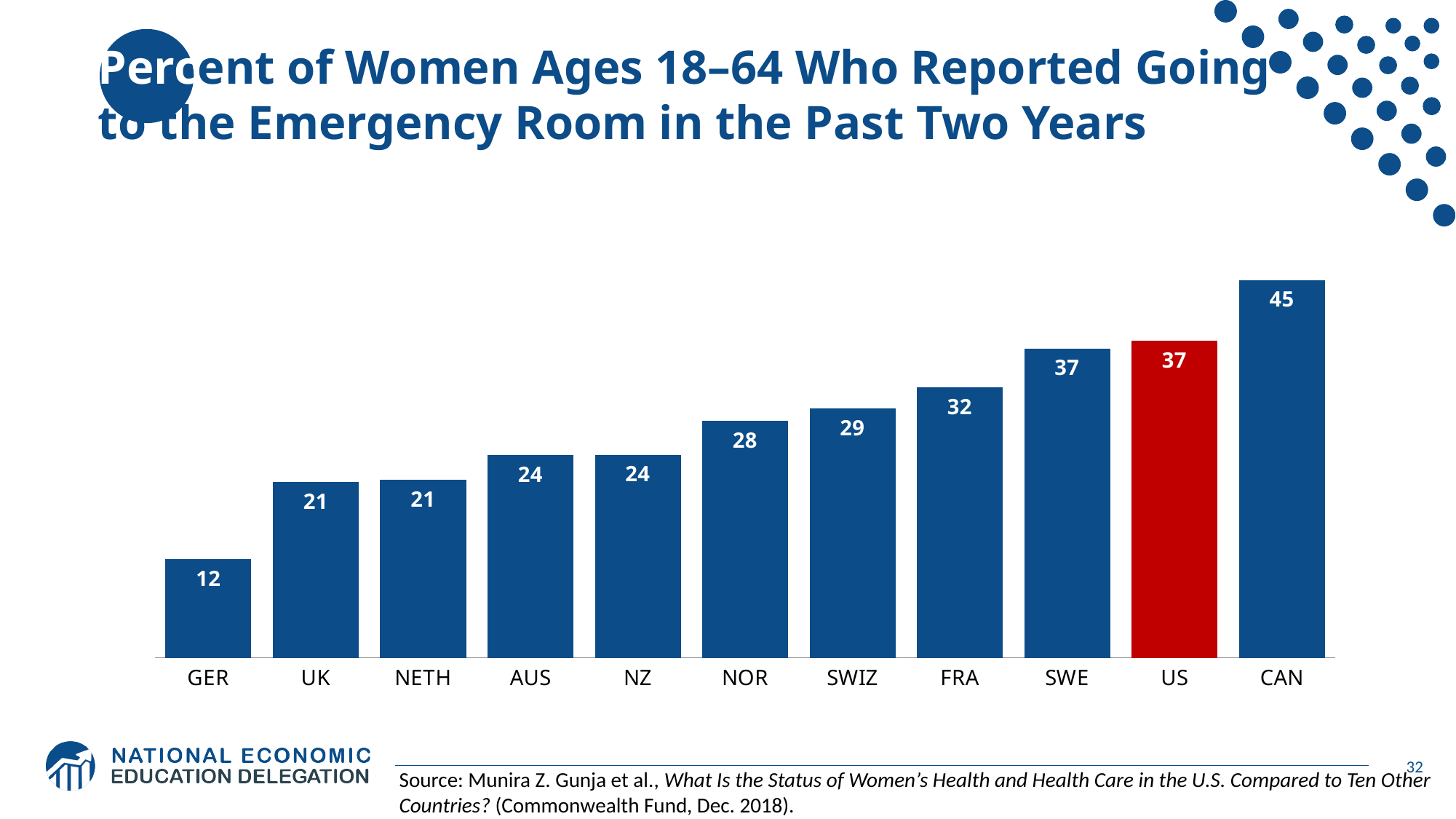
Do the values rise or fall from left to right along the x axis? rise How many countries are shown on the chart? 11 What is the value for NOR? 28 Which country has the lowest value? GER What kind of chart is this? bar chart What is the value for GER? 12 What is the difference between the values for FRA and GER? 20 Which country's bar is coloured red? US What is the difference between the values for CAN and the US? 8 What is the value for the US? 37 Which is larger, the value for SWIZ or the value for AUS? SWIZ Which country has the highest value? CAN